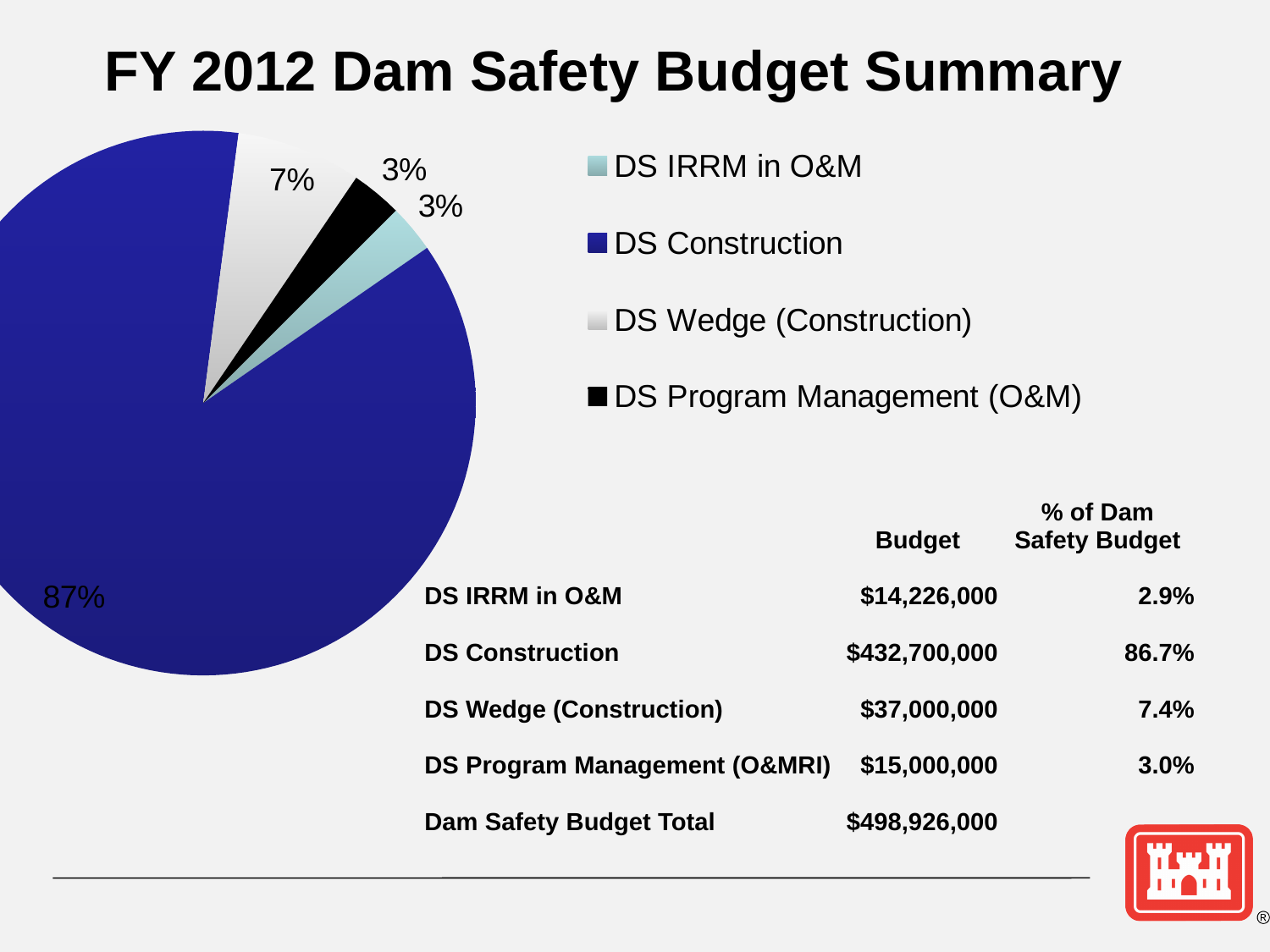
Which slice is larger, DS Construction or DS Wedge (Construction)? DS Construction What is the title of the slide containing the pie chart? FY 2012 Dam Safety Budget Summary How many slices does the pie chart have? 4 Which category has the largest slice of the pie? DS Construction How many entries does the chart legend list? 4 By how many percentage points does the DS Construction slice exceed the DS Wedge (Construction) slice? 80 percentage points Which slice is larger, DS Wedge (Construction) or DS IRRM in O&M? DS Wedge (Construction) What percentage of the pie does DS Construction account for? 87% What percentage of the pie does DS Wedge (Construction) account for? 7% What percentage of the pie does DS Program Management (O&M) account for? 3% What kind of chart is shown on the slide? pie chart What percentage of the pie does DS IRRM in O&M account for? 3%